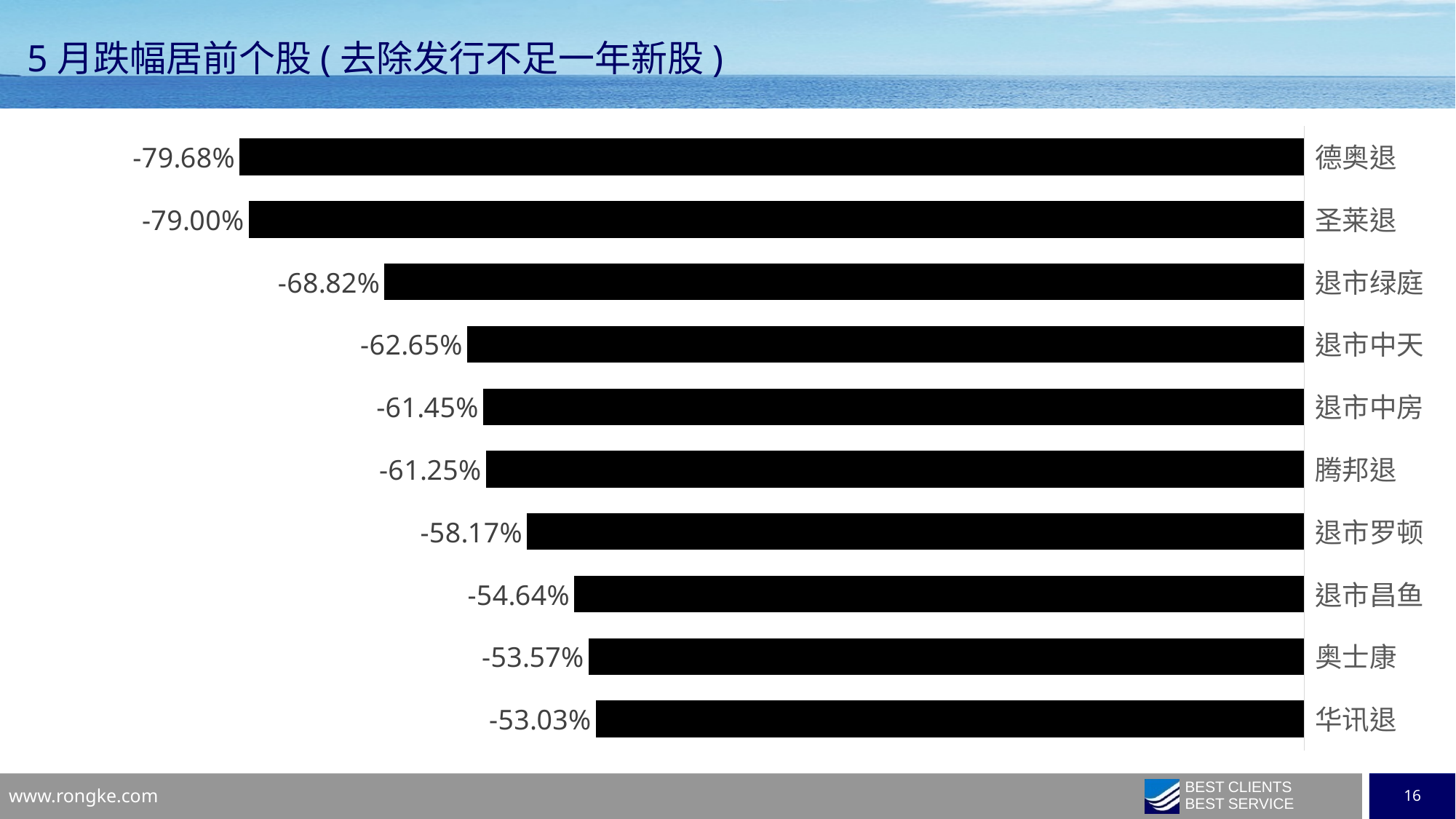
Which stock has the smallest decline (the least negative value) in the chart? 华讯退 What is the difference in percentage points between the values for 退市绿庭 and 退市中天? 6.17 percentage points What is the value shown for 退市罗顿? -58.17% How many stocks are shown in the chart? 10 What is the value shown for 退市绿庭? -68.82% What kind of chart is shown on the slide? Bar chart Which stock fell more in May, 退市昌鱼 or 腾邦退? 腾邦退 What is the title of the slide? 5月跌幅居前个股(去除发行不足一年新股) What is the difference in percentage points between the values for 德奥退 and 圣莱退? 0.68 percentage points Which stock has the largest decline (the most negative value) in the chart? 德奥退 What is the value shown for 奥士康? -53.57% What is the value shown for 德奥退? -79.68%